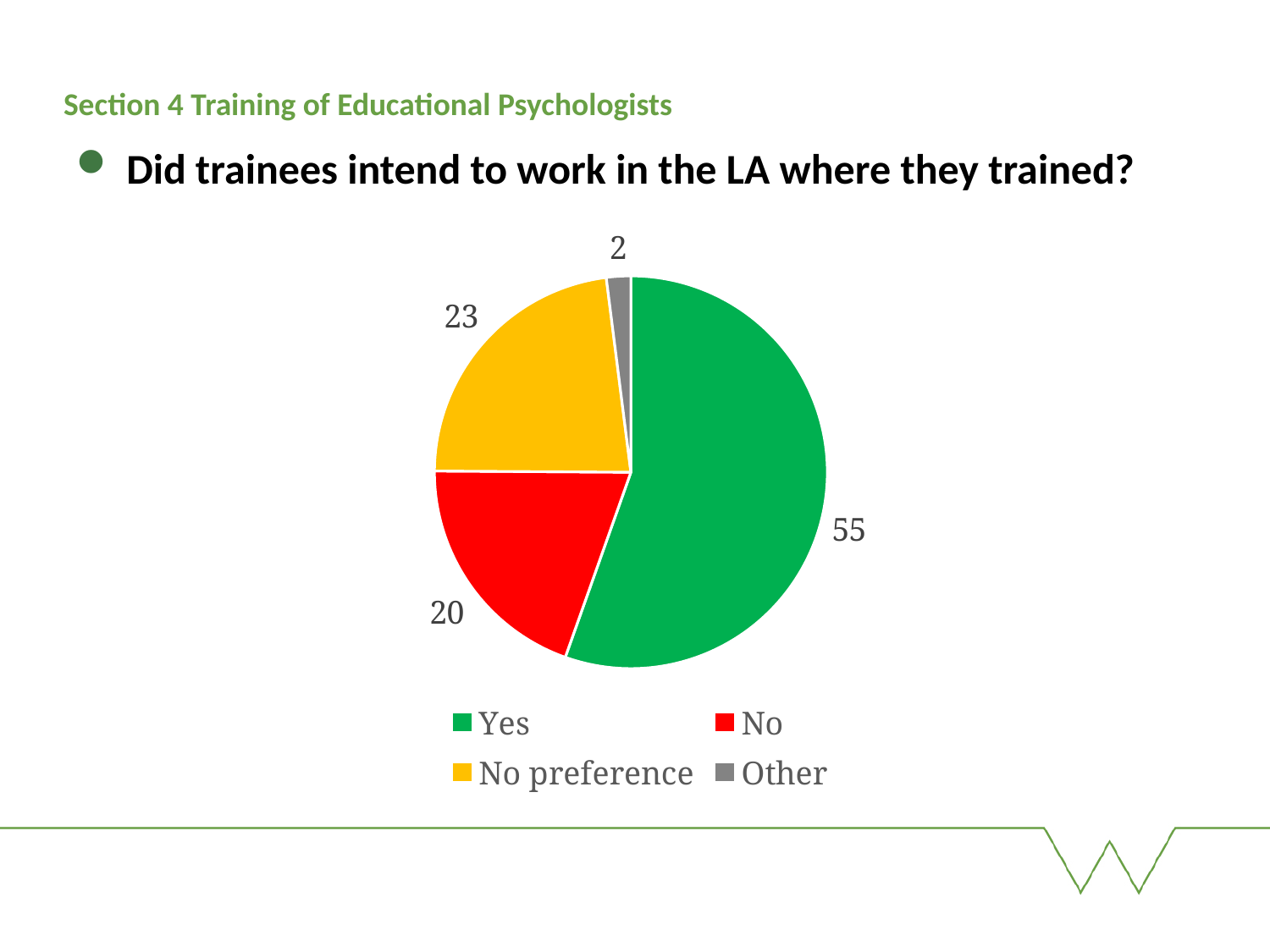
What colour is the Yes slice? green What is the difference between the values for Yes and No? 35 What kind of chart is shown on the slide? pie chart Which is larger, No preference or No? No preference What is the value for No preference? 23 What is the total of all the slices in the pie chart? 100 What is the value for Yes? 55 How many categories does the pie chart have? 4 What is the value for No? 20 Which category has the largest slice? Yes What is the value for Other? 2 Which category has the smallest slice? Other